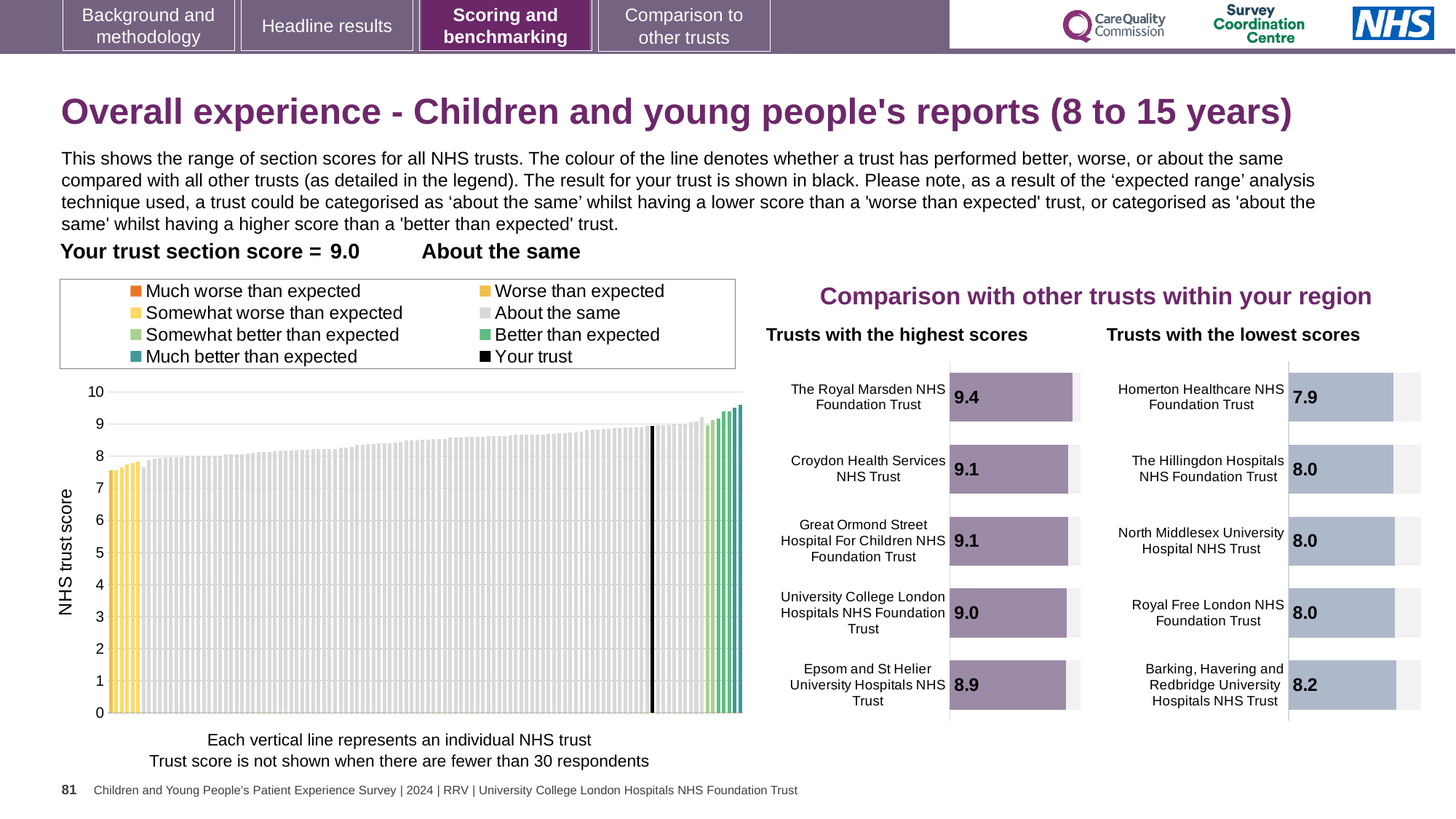
In the 'Trusts with the highest scores' chart, what is the score for The Royal Marsden NHS Foundation Trust? 9.4 In the 'Trusts with the highest scores' chart, what is the difference between the scores of The Royal Marsden NHS Foundation Trust and Epsom and St Helier University Hospitals NHS Trust? 0.5 What type of chart is the 'NHS trust score' chart on the left of the slide? Bar chart In the 'Trusts with the lowest scores' chart, which has the larger score: Homerton Healthcare NHS Foundation Trust or Barking, Havering and Redbridge University Hospitals NHS Trust? Barking, Havering and Redbridge University Hospitals NHS Trust In the 'NHS trust score' chart on the left, do the bar values rise or fall from left to right? Rise How many entries does the legend of the 'NHS trust score' chart on the left list? 8 In the 'Trusts with the lowest scores' chart, which trust has the lowest score? Homerton Healthcare NHS Foundation Trust In the 'NHS trust score' chart on the left, is the value of the leftmost bar greater or less than 8? less How many trusts are shown in the 'Trusts with the highest scores' chart? 5 In the 'Trusts with the lowest scores' chart, what is the score for Barking, Havering and Redbridge University Hospitals NHS Trust? 8.2 In the 'Trusts with the lowest scores' chart, what is the score for Homerton Healthcare NHS Foundation Trust? 7.9 In the 'Trusts with the highest scores' chart, which trust has the highest score? The Royal Marsden NHS Foundation Trust